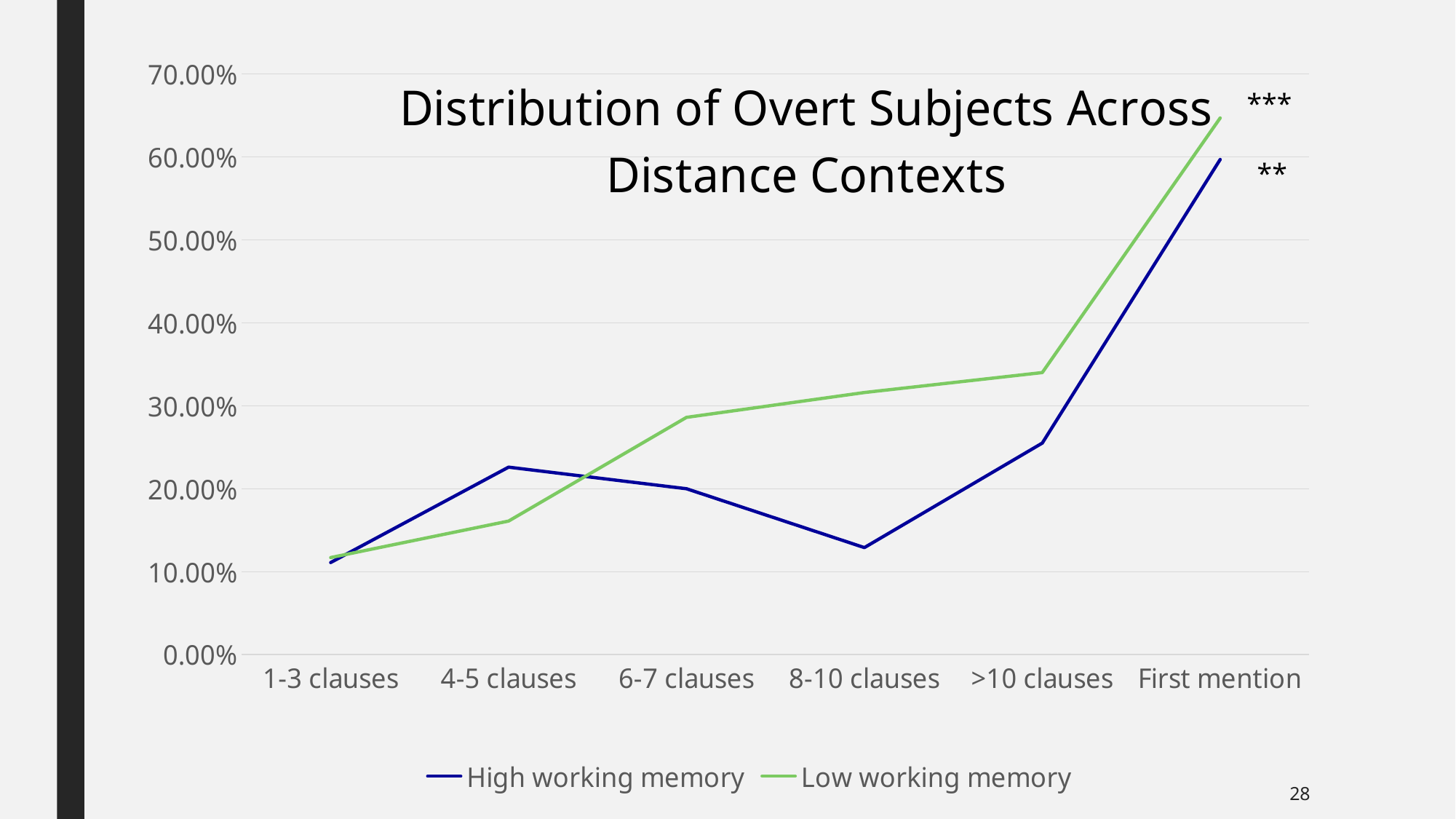
For which category is the High working memory value highest? First mention How many series does the legend list? 2 At 4-5 clauses, which series has the higher value, High working memory or Low working memory? High working memory What is the title of the chart? Distribution of Overt Subjects Across Distance Contexts How many distance context categories are shown on the x axis? 6 What kind of chart is shown on the slide? line chart Is the Low working memory value for >10 clauses greater or less than 30.00%? greater For which category is the Low working memory value lowest? 1-3 clauses At 6-7 clauses, which series has the higher value, High working memory or Low working memory? Low working memory Is the High working memory value for 8-10 clauses greater or less than 20.00%? less Does the Low working memory line rise or fall from 1-3 clauses to First mention? rise Is the High working memory value for First mention greater or less than 50.00%? greater